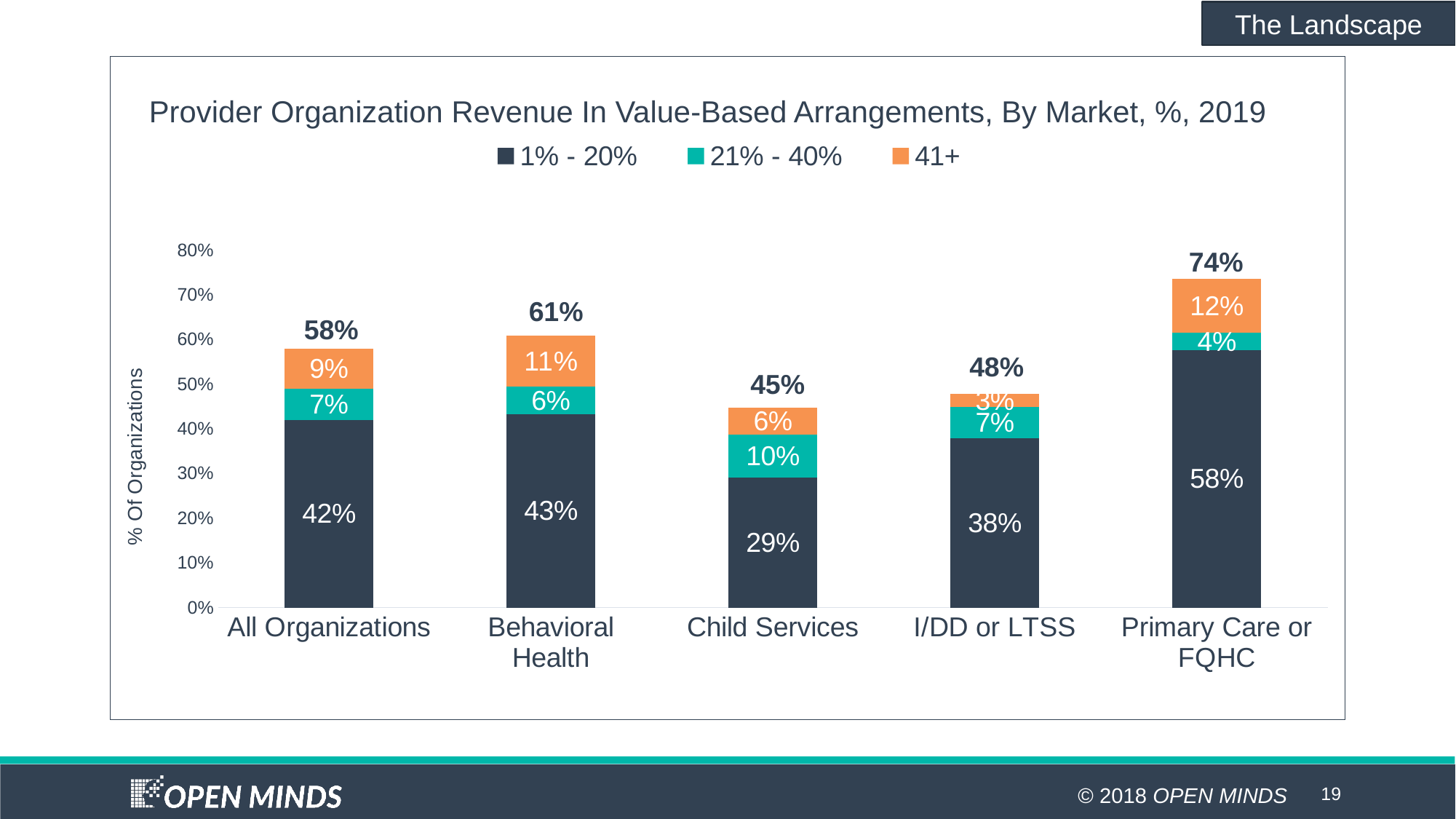
What is the title of the chart? Provider Organization Revenue In Value-Based Arrangements, By Market, %, 2019 What is the difference between the 1% - 20% values for Primary Care or FQHC and All Organizations? 16% Which category has the lowest stacked bar total? Child Services What kind of chart is shown on the slide? Stacked bar chart How many categories are shown on the x axis? 5 What is the value of the 1% - 20% series for Child Services? 29% Which category has the highest stacked bar total? Primary Care or FQHC What is the value of the 41+ series for Primary Care or FQHC? 12% Which is larger, the 41+ value for Behavioral Health or the 41+ value for Child Services? Behavioral Health What is the value of the 21% - 40% series for I/DD or LTSS? 7% How many series does the legend list? 3 What is the total shown above the stacked bar for Behavioral Health? 61%